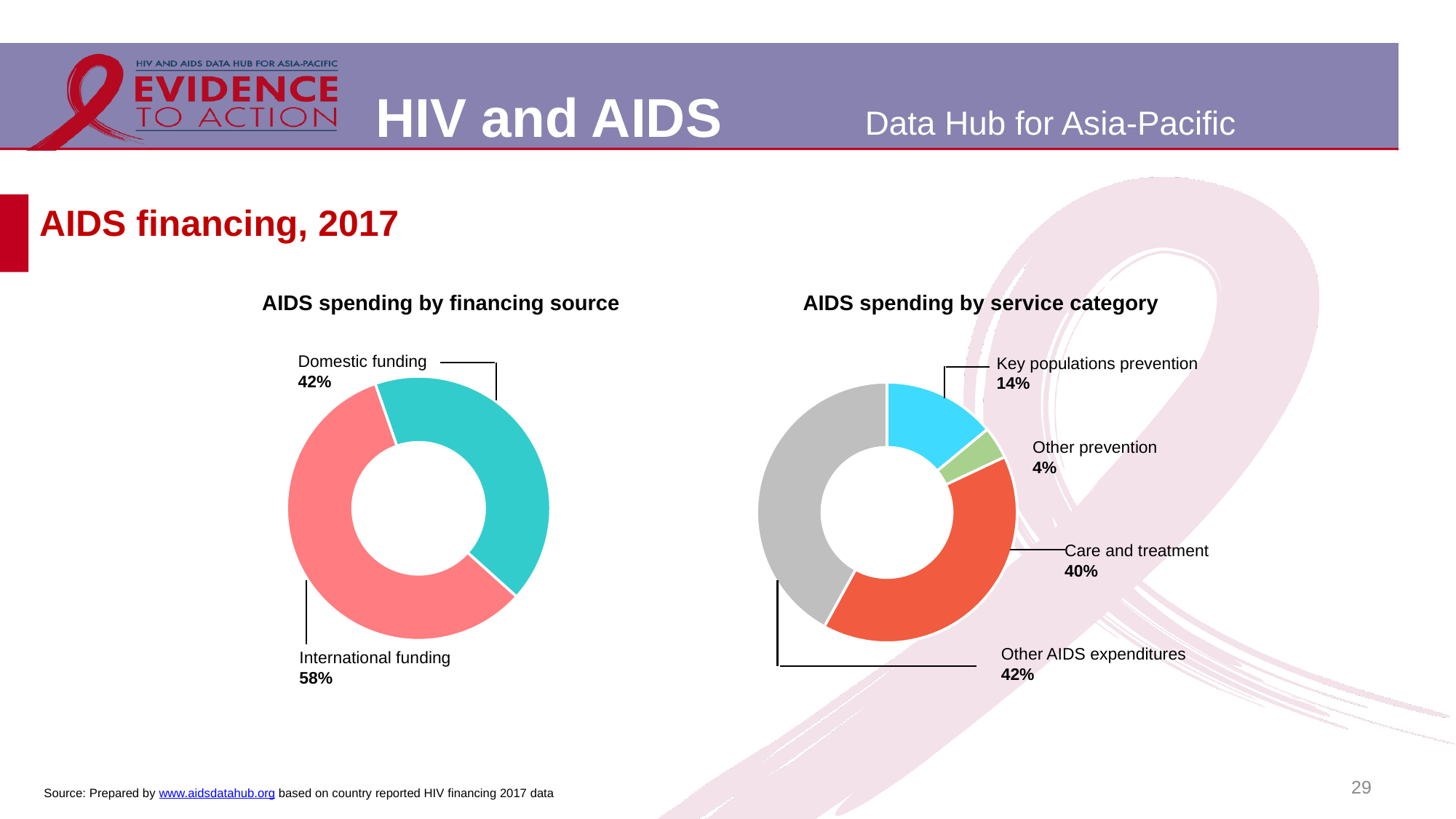
In the 'AIDS spending by financing source' chart, what share is International funding? 58% How many categories are shown in the 'AIDS spending by service category' chart? 4 In the 'AIDS spending by financing source' chart, what is the difference in percentage points between International funding and Domestic funding? 16 percentage points In the 'AIDS spending by service category' chart, which category has the largest share? Other AIDS expenditures In the 'AIDS spending by service category' chart, which is larger: Care and treatment or Key populations prevention? Care and treatment In the 'AIDS spending by financing source' chart, what share is Domestic funding? 42% In the 'AIDS spending by service category' chart, which category has the smallest share? Other prevention In the 'AIDS spending by service category' chart, what share is Care and treatment? 40% In the 'AIDS spending by service category' chart, what share is Other prevention? 4% What kind of chart is the 'AIDS spending by financing source' chart? Pie (donut) chart In the 'AIDS spending by service category' chart, what share is Key populations prevention? 14% In the 'AIDS spending by financing source' chart, which financing source has the larger share? International funding